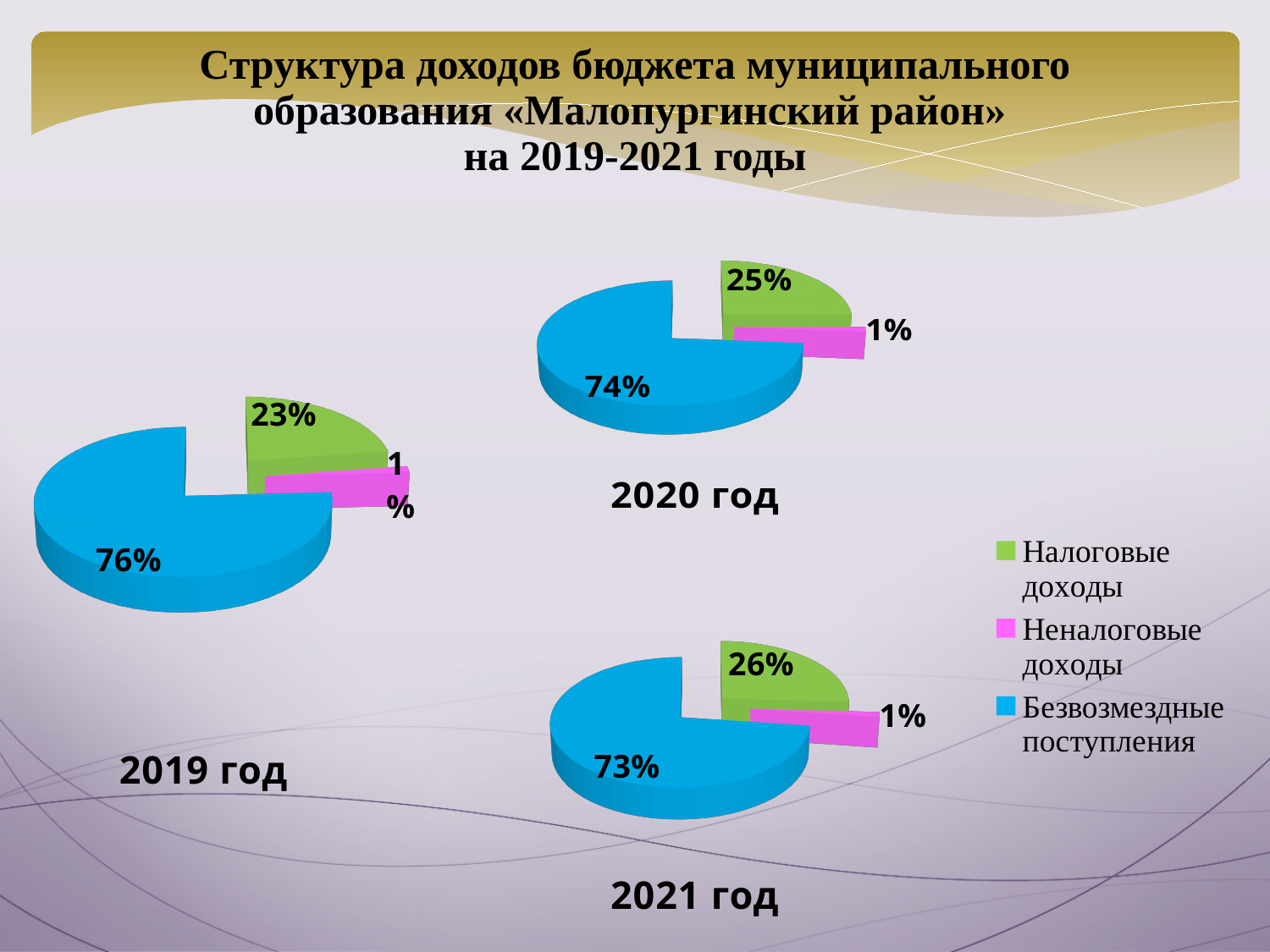
What type of chart is used for the 2020 год data? Pie chart Which is larger: the Безвозмездные поступления share in the 2019 год chart or in the 2021 год chart? 2019 год How many categories does the legend list for the pie charts? 3 In the 2021 год pie chart, which category has the largest slice? Безвозмездные поступления In the 2020 год pie chart, which category has the smallest slice? Неналоговые доходы In the 2019 год pie chart, what share is labelled for Налоговые доходы? 23% In the 2019 год pie chart, what share is labelled for Безвозмездные поступления? 76% In the 2020 год pie chart, what share is labelled for Налоговые доходы? 25% What is the difference between the Налоговые доходы share in the 2021 год chart and in the 2019 год chart? 3%